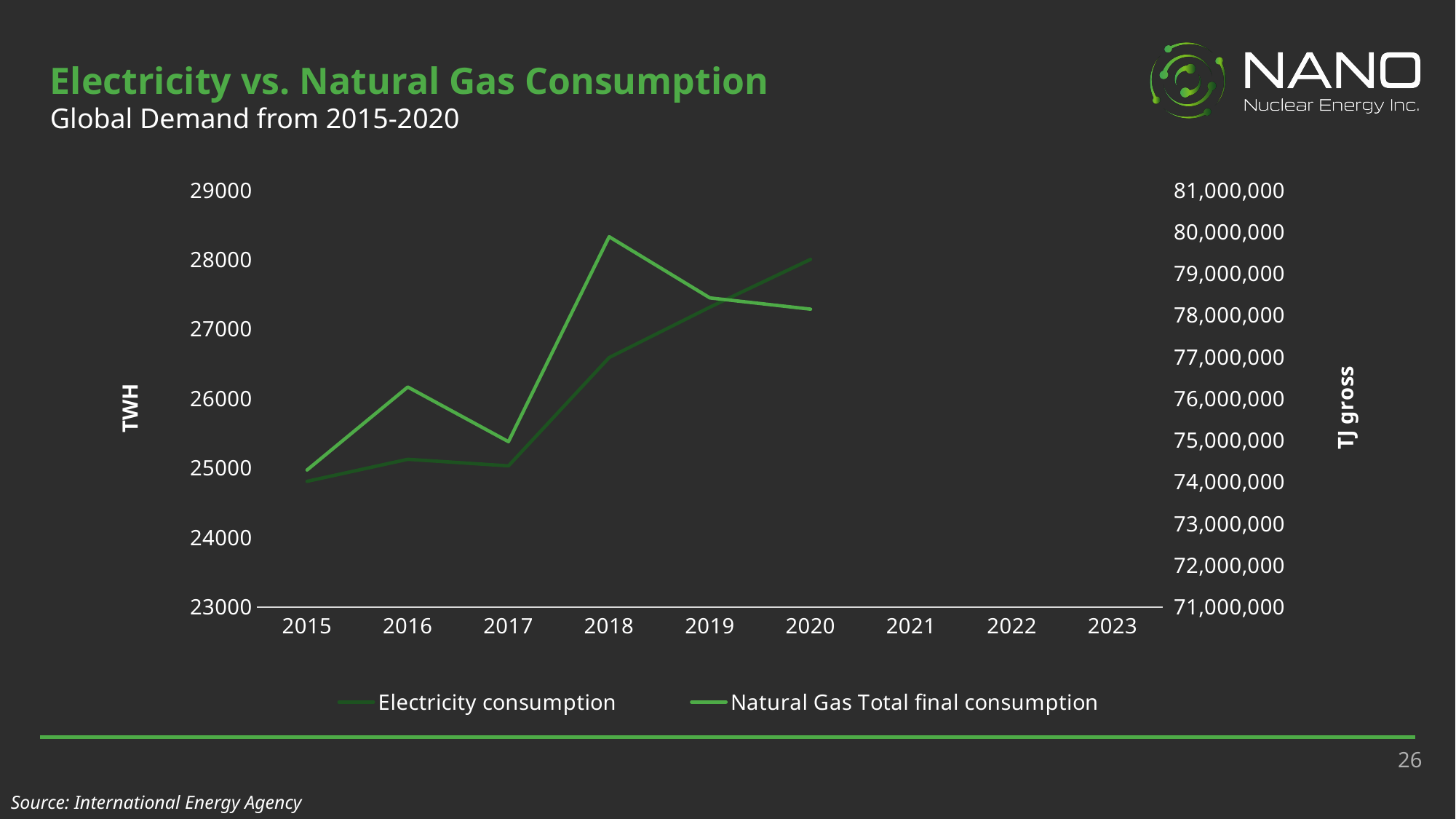
What is the label on the left vertical axis? TWH Is Electricity consumption higher in 2017 or in 2018? 2018 What is the label on the right vertical axis? TJ gross In which year does the Natural Gas Total final consumption line reach its highest point? 2018 How many years have plotted data points on the chart? 6 Is Natural Gas Total final consumption higher in 2018 or in 2020? 2018 What kind of chart is shown on the slide? line chart How many series does the legend list? 2 In which year is the Natural Gas Total final consumption line at its lowest point? 2015 Is the Electricity consumption value for 2020 greater or less than 27000 TWH? greater In which year does the Electricity consumption line reach its highest point? 2020 Does Electricity consumption generally rise or fall from 2015 to 2020? rise